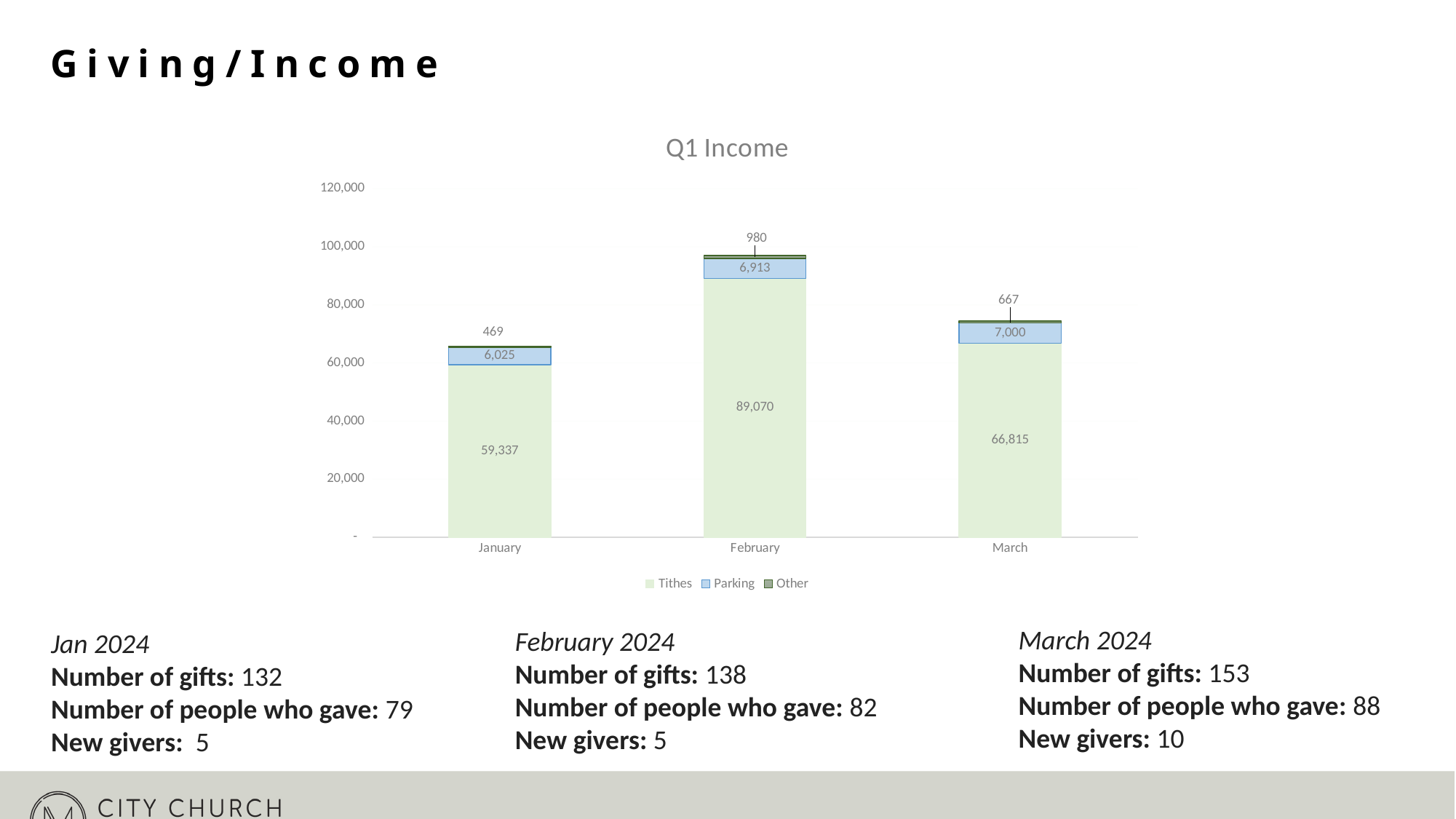
Is the total income for February greater or less than 80,000? greater What is the title of the chart? Q1 Income How many months are shown on the x axis of the chart? 3 How many series does the legend list? 3 What is the Other value for January? 469 Which month has the lowest Parking value? January What type of chart is shown on the slide? Stacked bar chart What is the total of the stacked bar for March? 74,482 Which month has the highest Tithes value? February What is the Tithes value for February? 89,070 What is the Parking value for March? 7,000 What is the difference between the Tithes values for February and January? 29,733